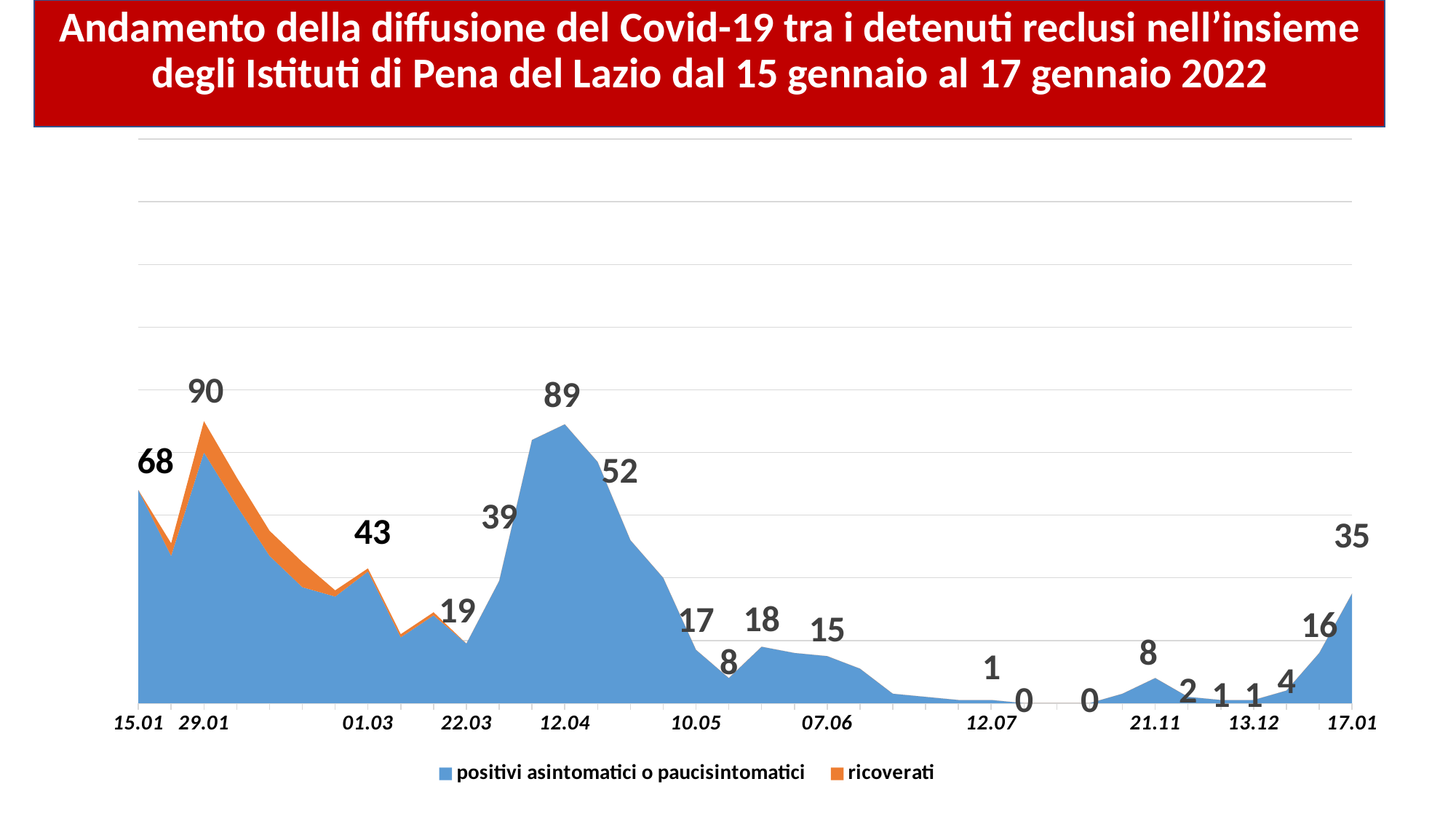
What value is labelled at 17.01 (the last date)? 35 How many series does the legend list? 2 What kind of chart is shown on the slide? area chart Do the values rise or fall between 12.04 and 12.07? fall Which is larger, the value labelled at 15.01 or the value labelled at 01.03? 15.01 What is the difference between the value labelled 89 at 12.04 and the next labelled value, 52? 37 What value is labelled at 12.04? 89 What are the two series named in the legend? positivi asintomatici o paucisintomatici; ricoverati What value is labelled at 29.01? 90 At which date does the chart reach its highest labelled value? 29.01 What value is labelled at 01.03? 43 What is the lowest value labelled on the chart? 0